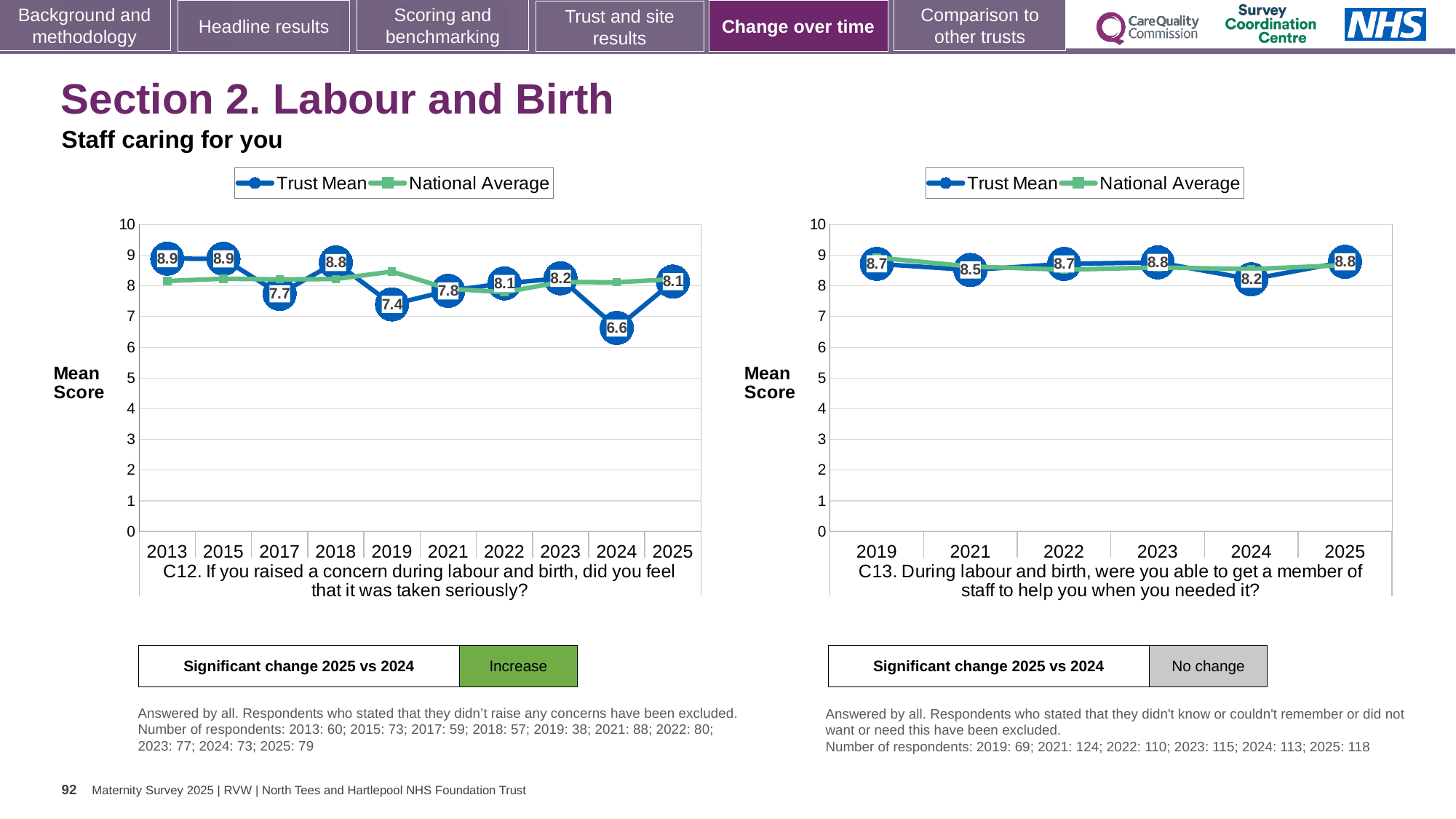
In the C12 chart on the left, which is larger: the Trust Mean for 2018 or the Trust Mean for 2019? 2018 In the C12 chart on the left, what is the Trust Mean for 2019? 7.4 In the C13 chart on the right, what is the Trust Mean for 2021? 8.5 What kind of chart is the C13 chart on the right? Line chart In the C12 chart on the left, what is the Trust Mean for 2024? 6.6 In the C12 chart on the left, which year has the lowest Trust Mean? 2024 How many series does the legend of the C13 chart on the right list? 2 How many years are plotted on the x axis of the C12 chart on the left? 10 In the C12 chart on the left, what is the difference between the Trust Mean for 2025 and the Trust Mean for 2024? 1.5 In the C12 chart on the left, is the National Average for 2013 greater or less than 9? less In the C13 chart on the right, what is the difference between the Trust Mean for 2025 and the Trust Mean for 2024? 0.6 In the C13 chart on the right, which year has the lowest Trust Mean? 2024